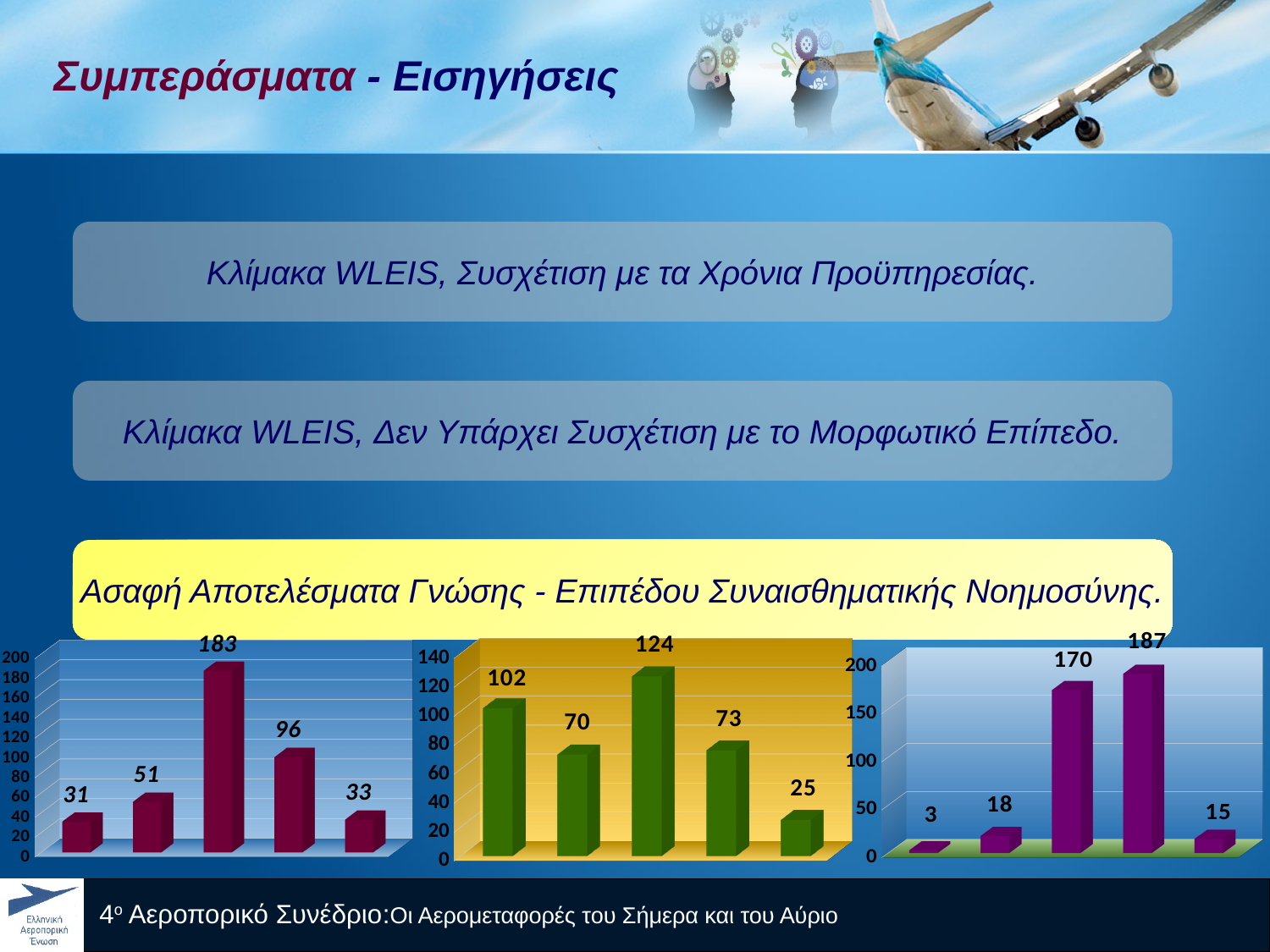
In the right chart, what is the highest value shown? 187 In the middle chart, is the value of the third bar greater or less than 100? greater In the middle chart, what is the lowest value shown? 25 In the right chart, which is larger: the third bar (170) or the fourth bar (187)? 187 What colour are the bars in the middle chart? green In the right chart, what is the value of the last bar on the right? 15 In the left chart, what is the value of the third bar from the left? 183 What kind of chart is the middle chart? bar chart In the left chart, what is the difference between the highest bar (183) and the lowest bar (31)? 152 In the middle chart, what is the value of the first bar from the left? 102 What is the total of all five bars in the right chart (3, 18, 170, 187, 15)? 393 How many bars does the left chart have? 5